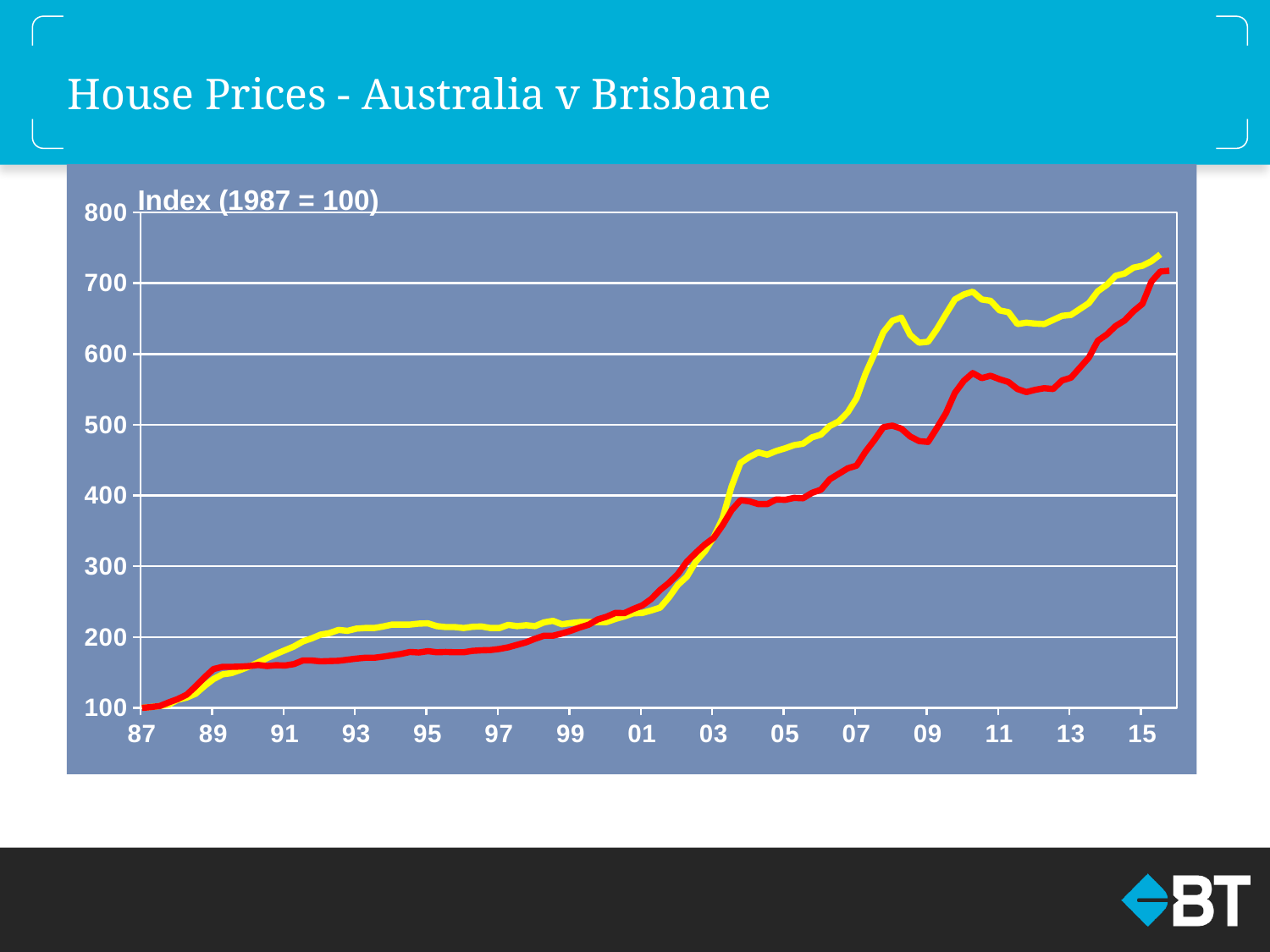
Is the value of the red line at 09 greater or less than 500? less What kind of chart is shown on the slide? line chart How many lines are plotted on the chart? 2 What is the index value of both lines at the start of the chart in 1987? 100 Do the values of the yellow line generally rise or fall from 87 to 15? rise Is the value of the red line at 93 greater or less than 200? less Is the value of the yellow line at 05 greater or less than 400? greater How many year labels are shown along the x axis? 15 At 13, which line is higher, the yellow line or the red line? yellow line What label is printed above the y axis of the chart? Index (1987 = 100) What is the title of the slide's chart? House Prices - Australia v Brisbane